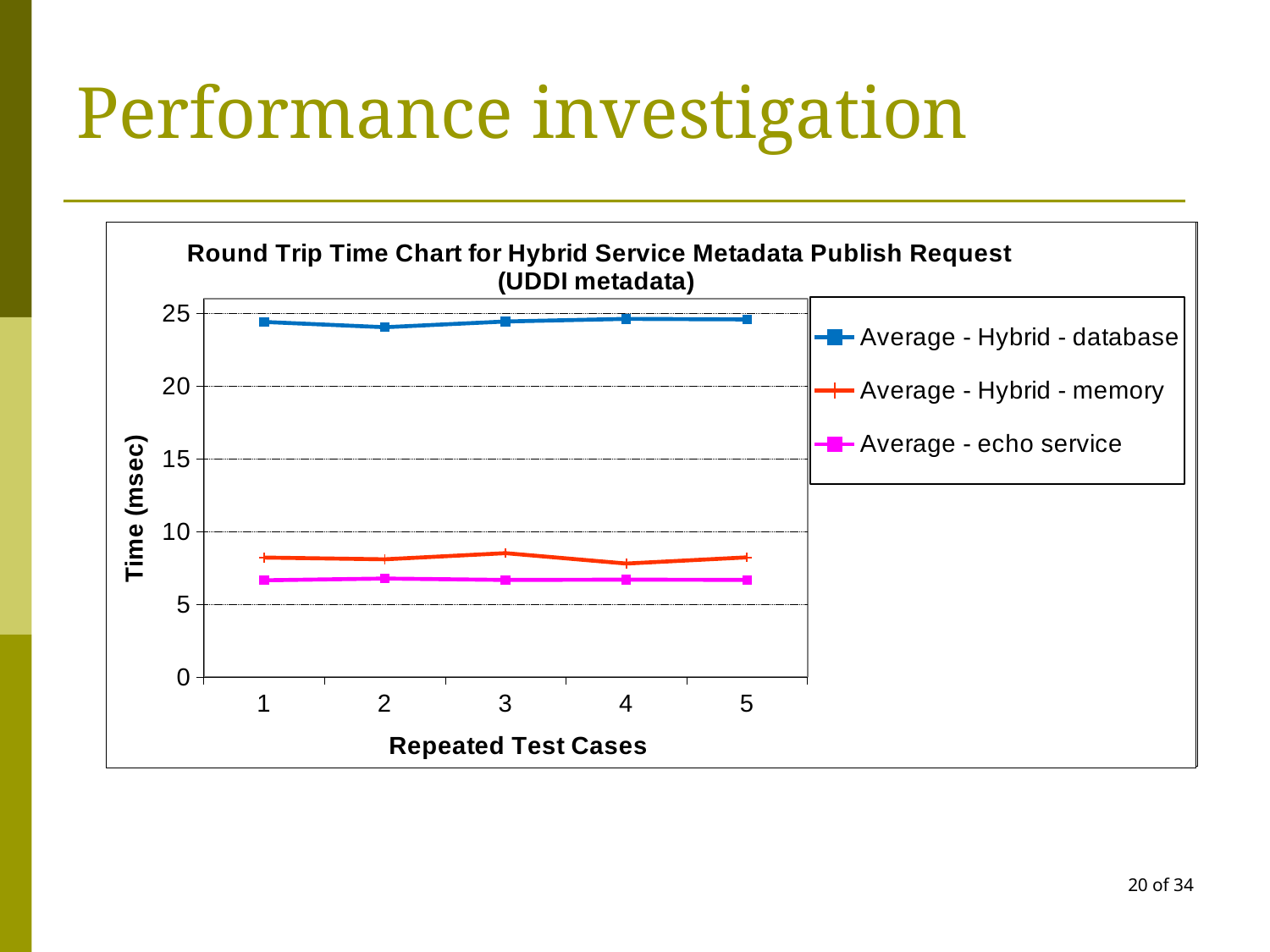
Does the Average - Hybrid - database series rise sharply, fall sharply, or stay roughly flat across the test cases? stay roughly flat What is the title of the chart? Round Trip Time Chart for Hybrid Service Metadata Publish Request (UDDI metadata) What is the label of the y axis? Time (msec) How many repeated test cases are plotted along the x axis? 5 What kind of chart is shown on the slide? line chart Is the value for Average - Hybrid - memory at test case 1 greater or less than 10? less Is the value for Average - echo service at test case 5 greater or less than 5? greater How many series does the legend list? 3 Which series has the lowest round trip time across all test cases? Average - echo service At test case 4, which is larger: Average - Hybrid - memory or Average - echo service? Average - Hybrid - memory Is the value for Average - Hybrid - database at test case 3 greater or less than 20? greater Which series has the highest round trip time across all test cases? Average - Hybrid - database